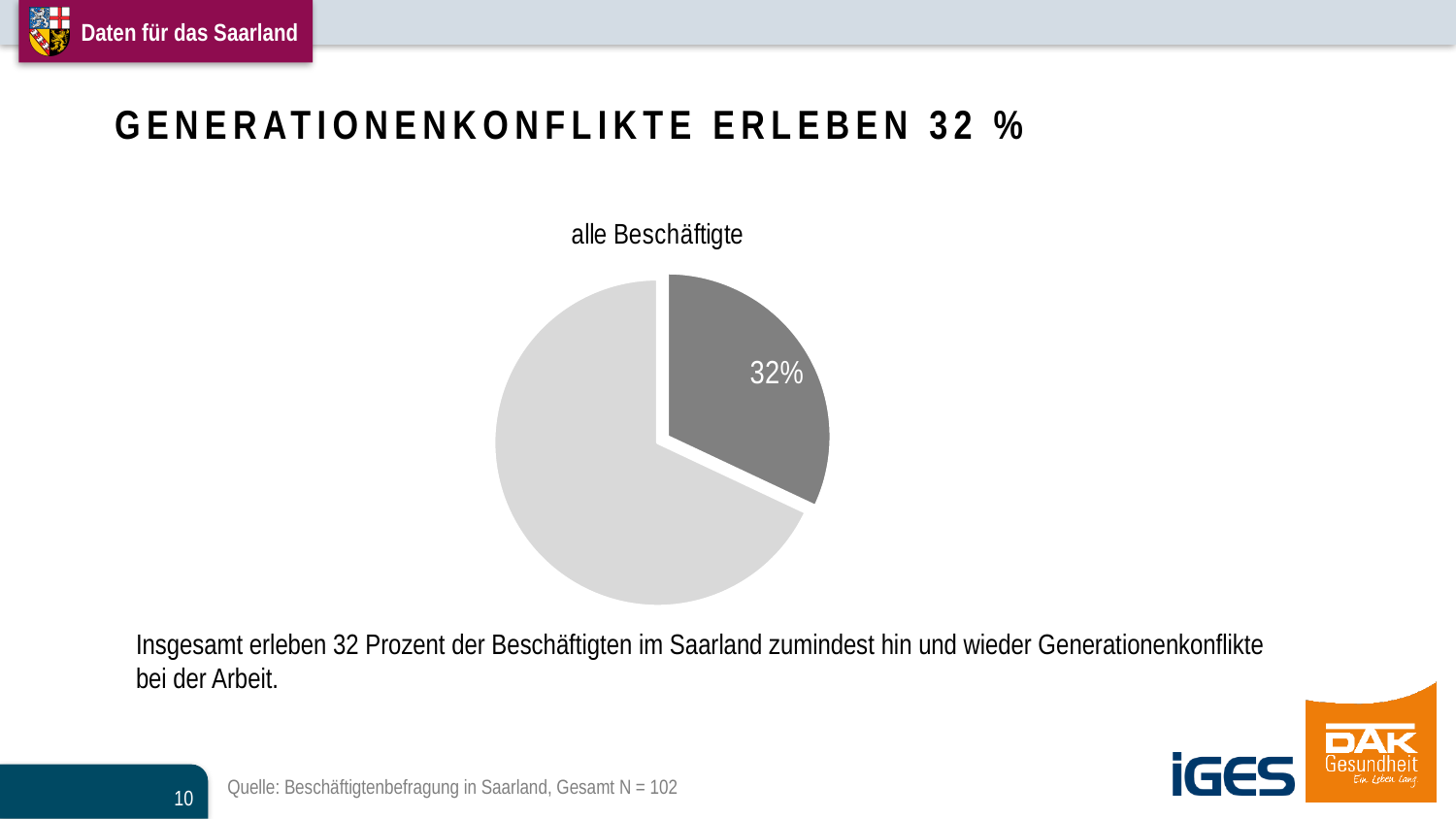
What share of the pie does the labelled slice represent? 32% How many slices does the pie chart have? 2 Which slice of the pie chart is the smallest? the dark grey slice (32%) What is the title of the pie chart? alle Beschäftigte What colour is the slice labelled 32%? dark grey What kind of chart is shown on the slide? pie chart Which slice of the pie chart is larger, the dark grey one or the light grey one? the light grey one What percentage is printed on the dark grey slice of the pie chart? 32% Is the share of the dark grey slice greater or less than 50%? less